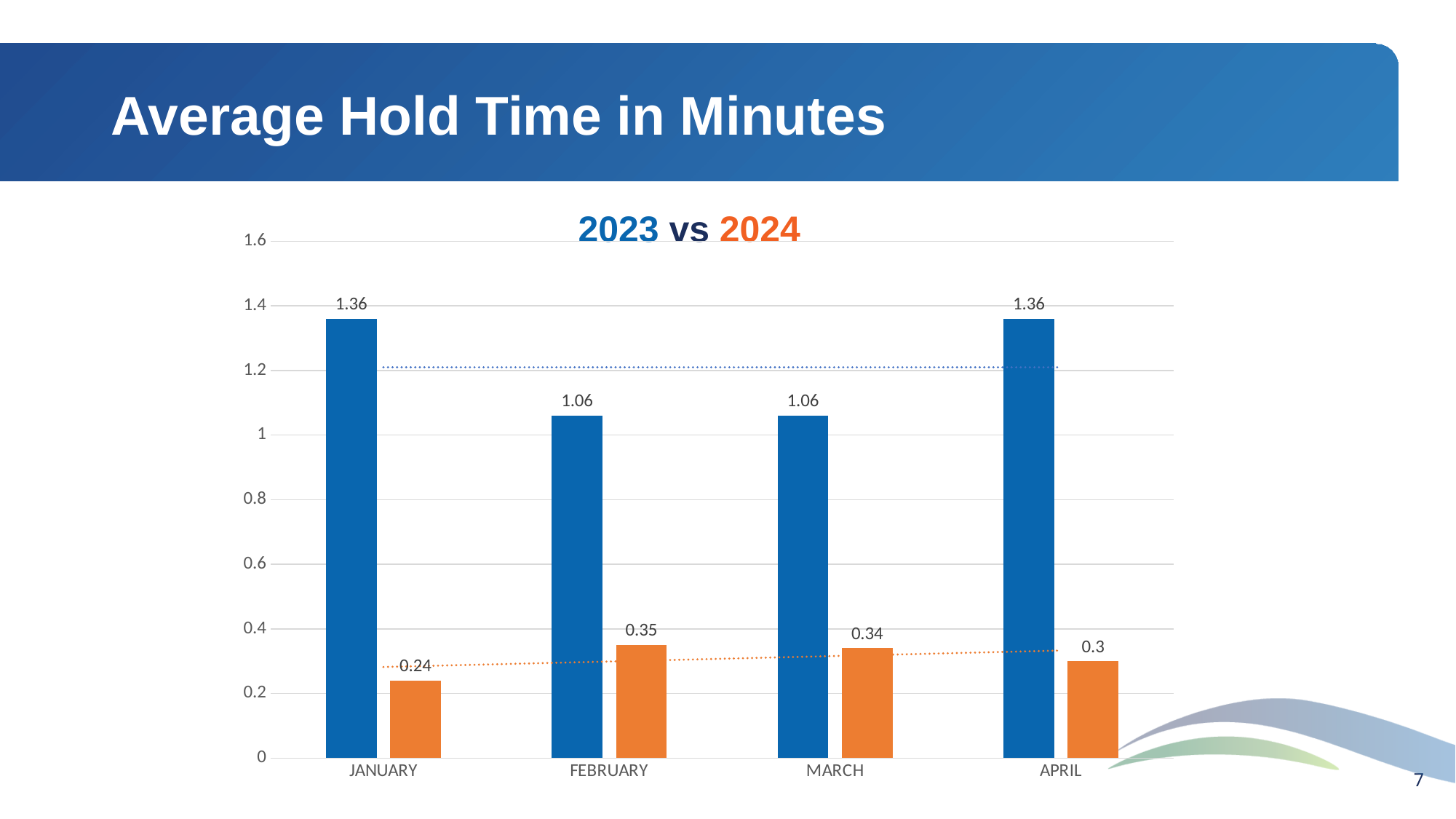
What is the 2024 average hold time for February? 0.35 How many months are shown on the x axis? 4 How many data series does the chart compare? 2 What is the 2023 average hold time for January? 1.36 What is the difference between the 2023 and 2024 average hold times for January? 1.12 What is the title of the chart? 2023 vs 2024 Which month has the lowest 2024 average hold time? January What is the 2023 average hold time for March? 1.06 What type of chart is shown on the slide? Bar chart Which is larger, the 2024 value for March or the 2024 value for April? March Which month has the highest 2024 average hold time? February What is the 2024 average hold time for April? 0.3